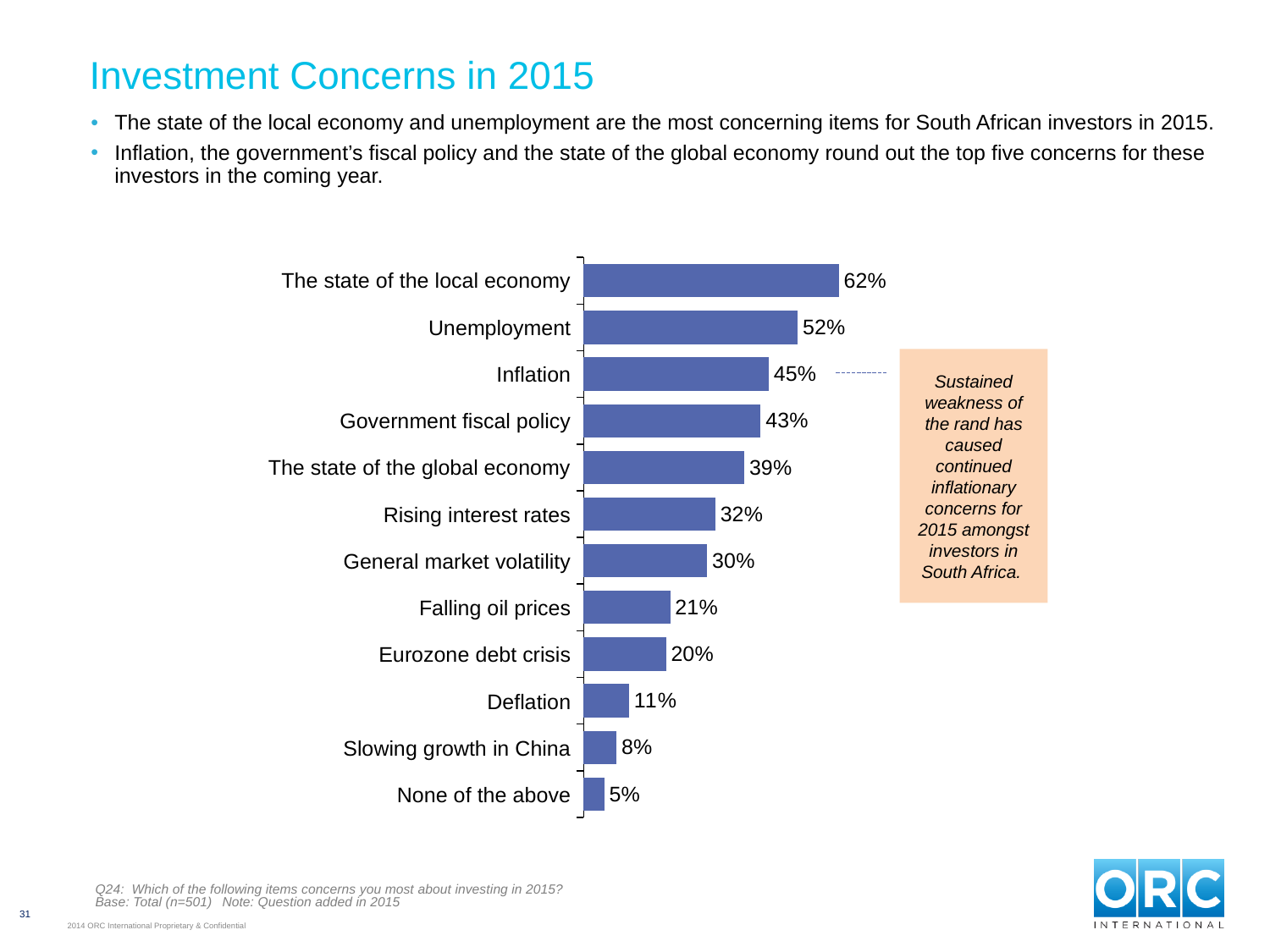
What is the value shown for Government fiscal policy? 43% Which category does the dashed line from the callout box point to? Inflation Which category has the lowest value in the chart? None of the above Which category has the highest value in the chart? The state of the local economy Do the values rise or fall going from the top bar to the bottom bar? Fall Which is larger, the value for Rising interest rates or the value for General market volatility? Rising interest rates What kind of chart is shown on the slide? Bar chart What is the difference between the values for Unemployment and Inflation? 7% What percentage of investors cited the state of the local economy as a concern? 62% What percentage is shown for Slowing growth in China? 8% What is the difference between the values for Falling oil prices and Deflation? 10% How many categories are shown in the chart? 12